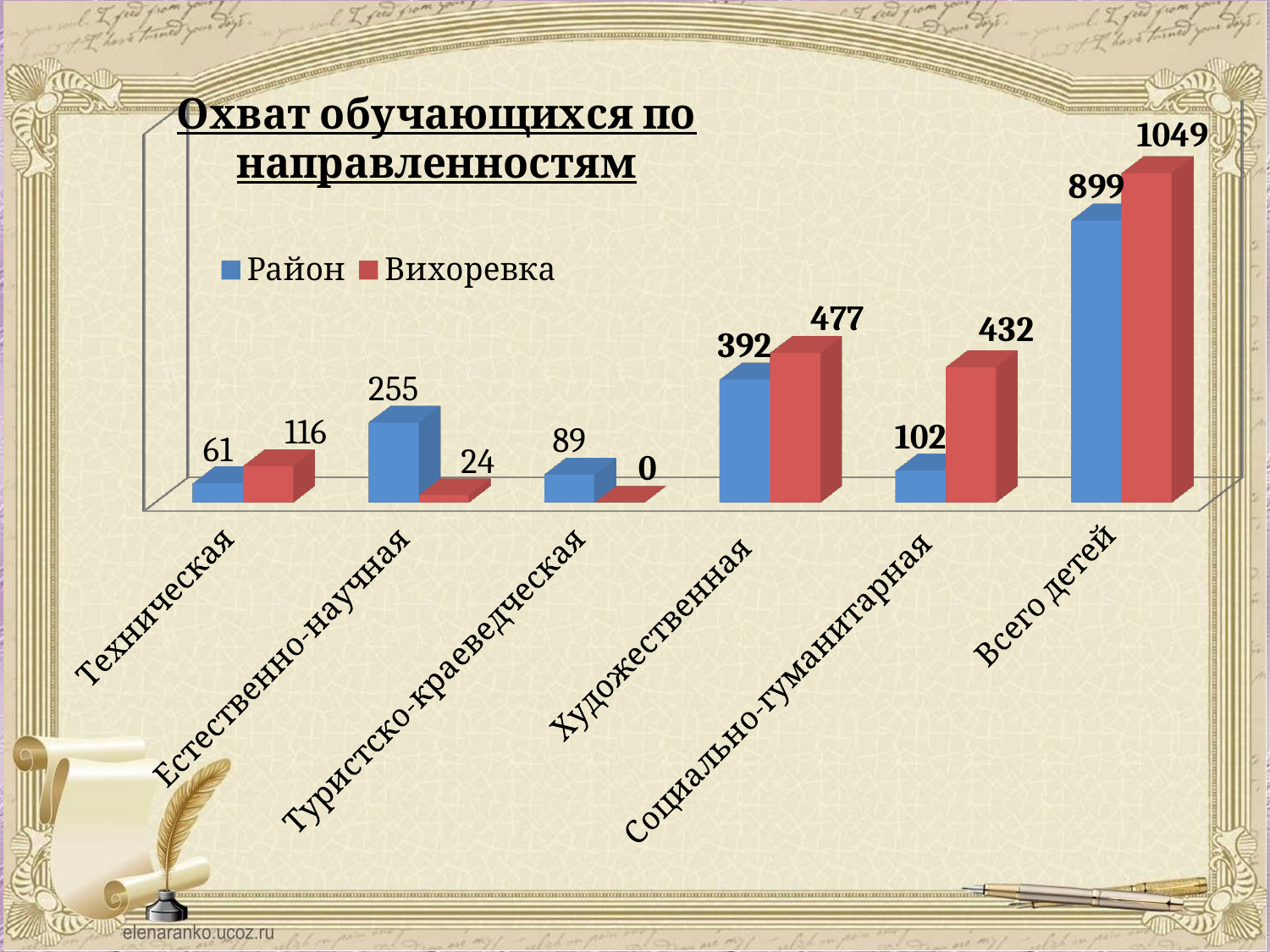
What is the difference between Район and Вихоревка in the Естественно-научная category? 231 What is the value for Район in the Всего детей category? 899 What is the value for Вихоревка in the Социально-гуманитарная category? 432 What kind of chart is shown on the slide? Bar chart Excluding Всего детей, which category has the highest value for Вихоревка? Художественная What is the value for Район in the Техническая category? 61 What is the difference between Вихоревка and Район in the Всего детей category? 150 How many series does the legend list? 2 Which category has the lowest value for Район? Техническая What is the value for Вихоревка in the Туристско-краеведческая category? 0 Which is larger in the Художественная category, Район or Вихоревка? Вихоревка How many categories are shown on the x axis? 6